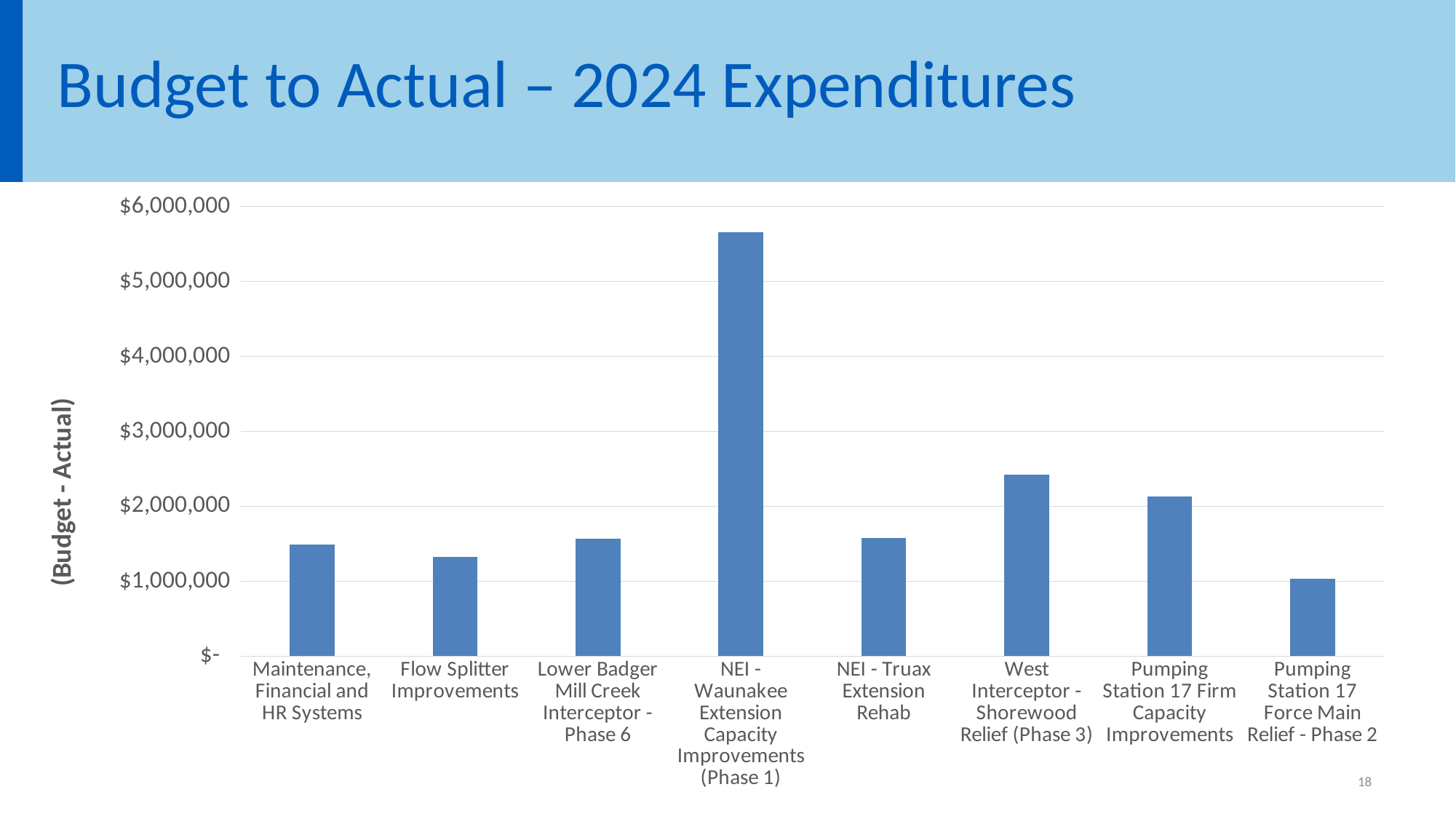
Is the value for Flow Splitter Improvements greater or less than $1,000,000? greater What kind of chart is shown on the slide? Bar chart Is the value for NEI - Waunakee Extension Capacity Improvements (Phase 1) greater or less than $5,000,000? greater How many projects (categories) are plotted in the chart? 8 Which project has the lowest (Budget - Actual) value? Pumping Station 17 Force Main Relief - Phase 2 Which project has the highest (Budget - Actual) value? NEI - Waunakee Extension Capacity Improvements (Phase 1) Is the value for West Interceptor - Shorewood Relief (Phase 3) greater or less than $2,000,000? greater Which is larger: the value for West Interceptor - Shorewood Relief (Phase 3) or for Pumping Station 17 Firm Capacity Improvements? West Interceptor - Shorewood Relief (Phase 3) What is the label on the vertical axis of the chart? (Budget - Actual) Which is larger: the value for Maintenance, Financial and HR Systems or for Flow Splitter Improvements? Maintenance, Financial and HR Systems